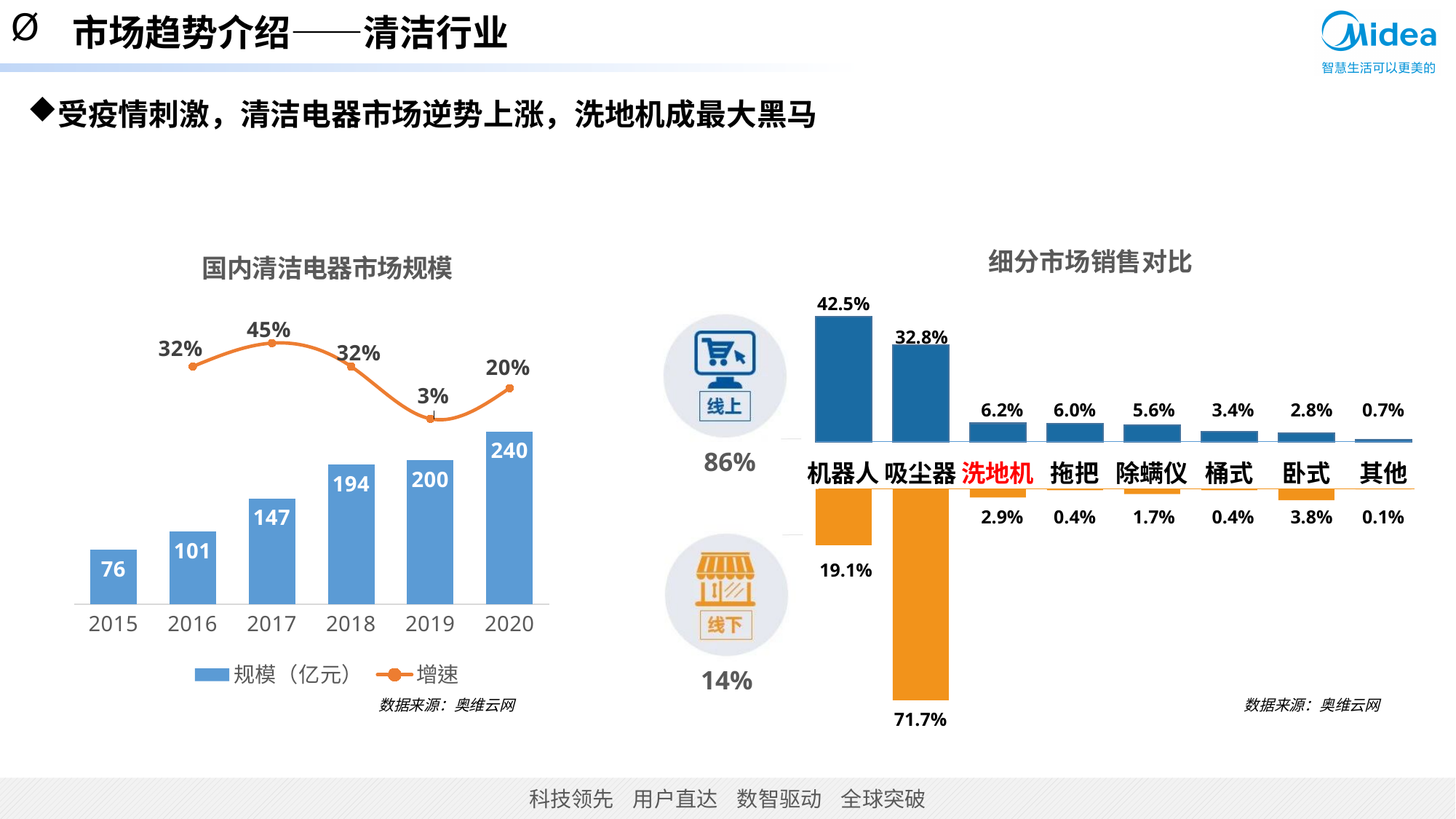
In the chart titled 国内清洁电器市场规模, what is the 增速 value for 2019? 3% In the chart titled 国内清洁电器市场规模, what is the difference between the 规模 values for 2020 and 2015? 164 In the chart titled 细分市场销售对比, what is the 线下 value for 吸尘器? 71.7% In the chart titled 细分市场销售对比, which category has the lowest 线下 value? 其他 In the chart titled 细分市场销售对比, which is larger for 卧式: the 线上 value or the 线下 value? 线下 In the chart titled 国内清洁电器市场规模, how many series does the legend list? 2 In the chart titled 国内清洁电器市场规模, do the 规模 bars rise or fall from 2015 to 2020? rise In the chart titled 国内清洁电器市场规模, what is the 规模 value for 2020? 240 In the chart titled 细分市场销售对比, which category has the highest 线上 value? 机器人 In the chart titled 国内清洁电器市场规模, which year has the highest 增速? 2017 In the chart titled 细分市场销售对比, what is the 线上 value for 洗地机? 6.2% In the chart titled 国内清洁电器市场规模, how many years are shown on the x axis? 6